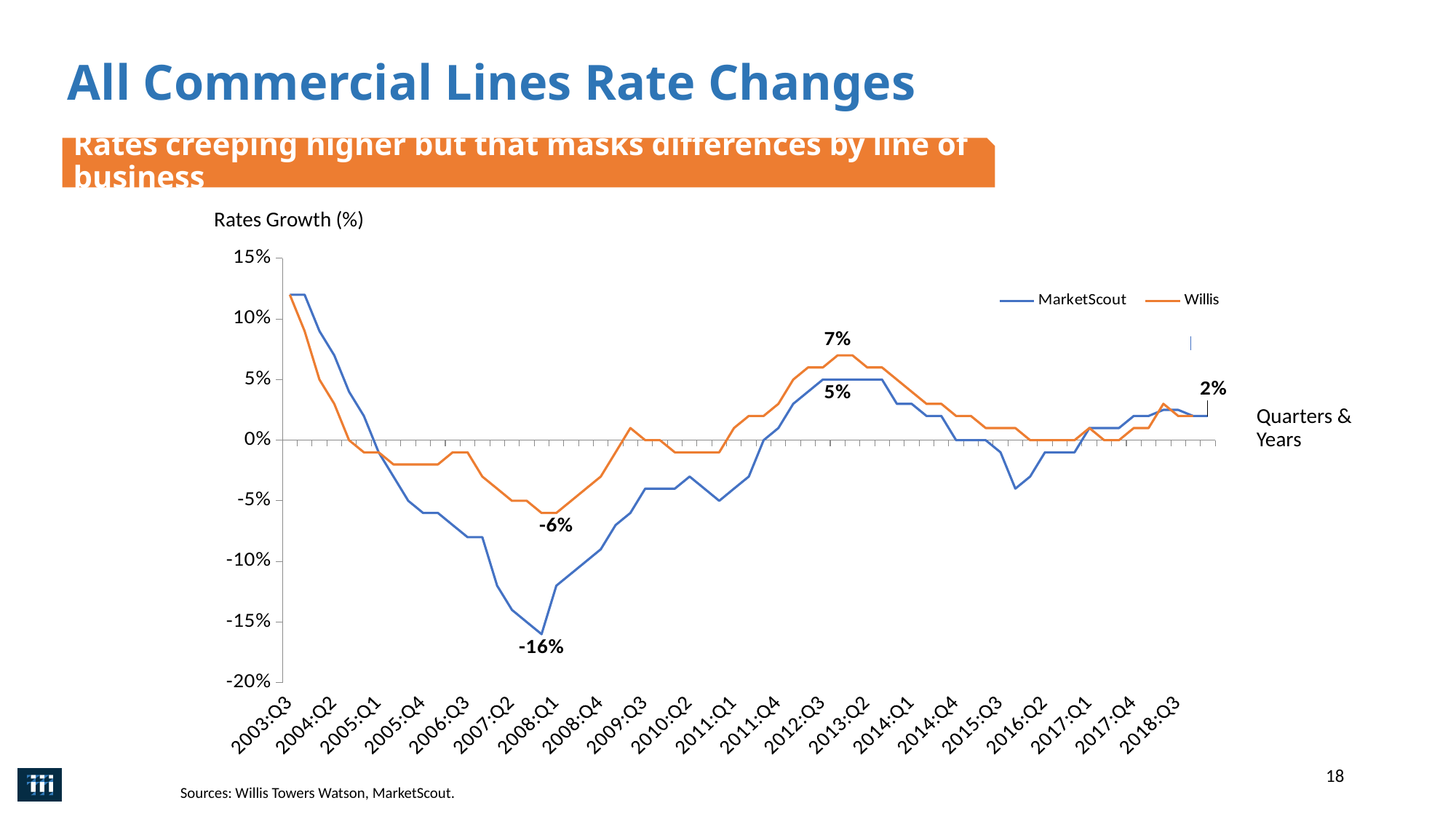
Do the MarketScout values rise or fall between 2003:Q3 and 2008:Q1? fall What is the lowest labelled value of the Willis series? -6% What are the two series named in the chart's legend? MarketScout and Willis What kind of chart is shown on the slide? Line chart What is the difference between the Willis peak label of 7% and the MarketScout peak label of 5%? 2 percentage points What is the labelled value at the right end of the chart, at the most recent quarter? 2% Is the MarketScout value at 2003:Q3 greater or less than 10%? greater What is the highest labelled value of the Willis series? 7% At the 2008 trough, which series is lower, MarketScout or Willis? MarketScout How many series does the chart's legend list? 2 What is the labelled peak value of the MarketScout series around 2013? 5% What is the lowest labelled value of the MarketScout series? -16%